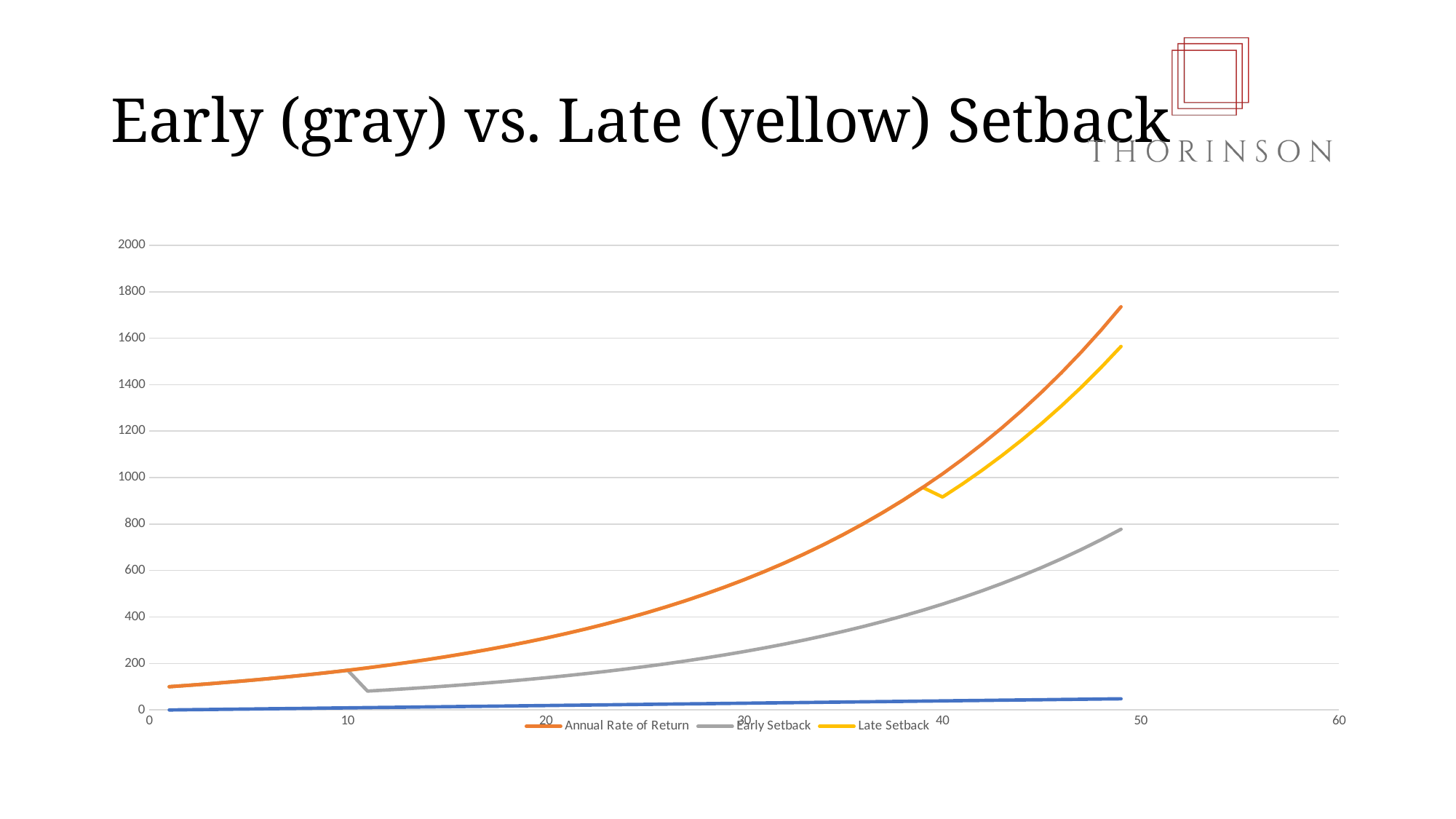
Does the Annual Rate of Return line rise or fall as the x axis increases? rise Is the value of Late Setback at its right end greater or less than 1400? greater What colour is the Annual Rate of Return line? orange What is the title of the slide containing the chart? Early (gray) vs. Late (yellow) Setback Is the value of Early Setback at its right end greater or less than 600? greater How many series does the chart legend list? 3 Is the value of Annual Rate of Return at its right end greater or less than 1600? greater What kind of chart is shown on the slide? line chart At the right end of the chart, which is higher, Early Setback or Late Setback? Late Setback Which series is highest at the right end of the chart? Annual Rate of Return